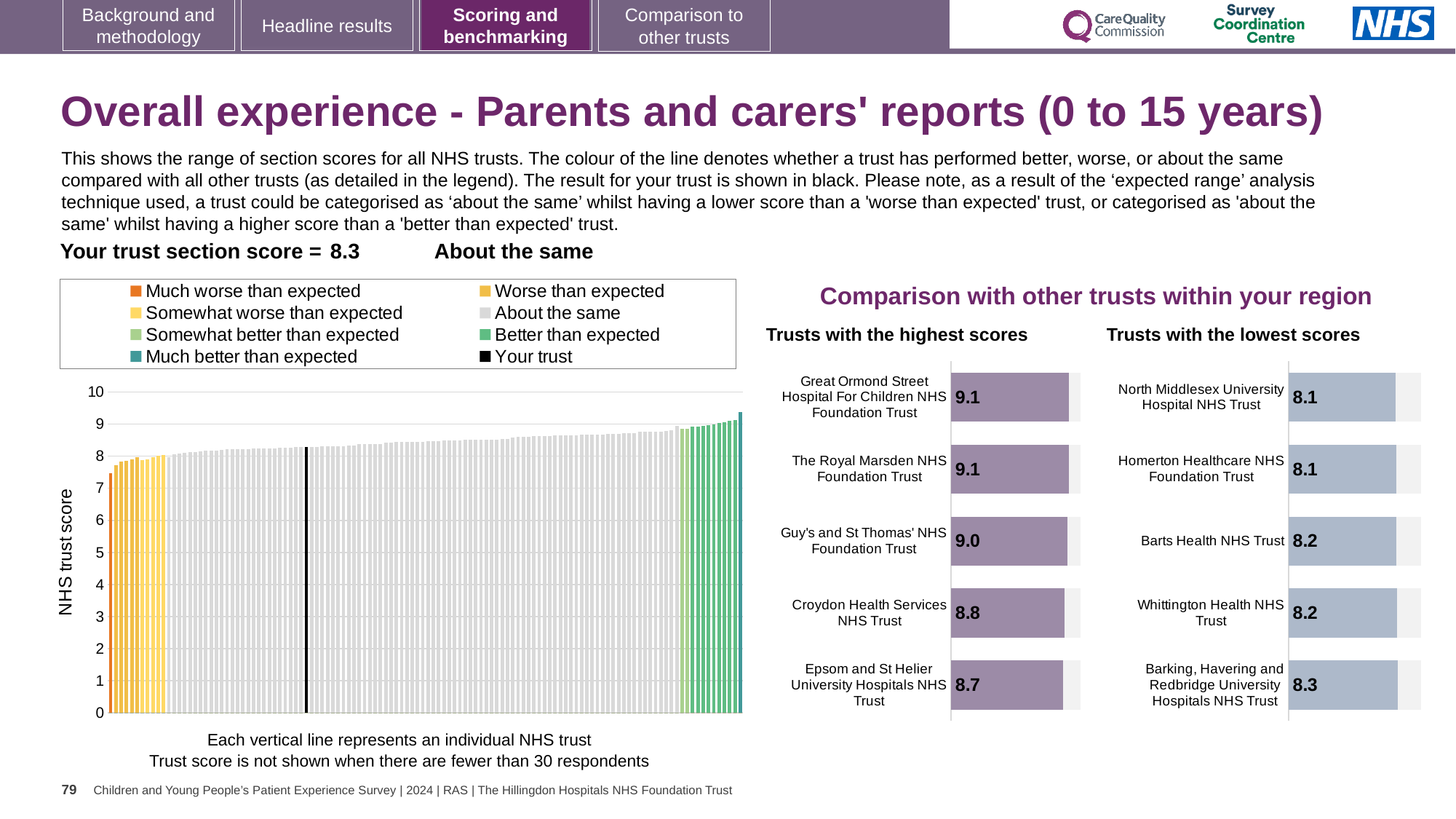
In the 'Trusts with the lowest scores' chart, what is the score for Barking, Havering and Redbridge University Hospitals NHS Trust? 8.3 In the 'Trusts with the highest scores' chart, what is the score for Croydon Health Services NHS Trust? 8.8 In the 'Trusts with the highest scores' chart, which has the higher score: Croydon Health Services NHS Trust or Epsom and St Helier University Hospitals NHS Trust? Croydon Health Services NHS Trust In the 'Trusts with the lowest scores' chart, what is the score for Barts Health NHS Trust? 8.2 In the 'Trusts with the highest scores' chart, what is the difference between the scores of Great Ormond Street Hospital For Children NHS Foundation Trust and Epsom and St Helier University Hospitals NHS Trust? 0.4 What kind of chart is the 'NHS trust score' chart on the left of the slide? bar chart In the 'Trusts with the highest scores' chart, which trust has the lowest score? Epsom and St Helier University Hospitals NHS Trust In the 'Trusts with the lowest scores' chart, which trust has the highest score? Barking, Havering and Redbridge University Hospitals NHS Trust How many trusts are listed in the 'Trusts with the highest scores' chart? 5 In the 'Trusts with the highest scores' chart, what is the score for Great Ormond Street Hospital For Children NHS Foundation Trust? 9.1 In the 'NHS trust score' chart on the left, is the value of the highest (rightmost) bar greater or less than 9? greater In the 'NHS trust score' chart on the left, what is the section score for your trust (shown in black)? 8.3